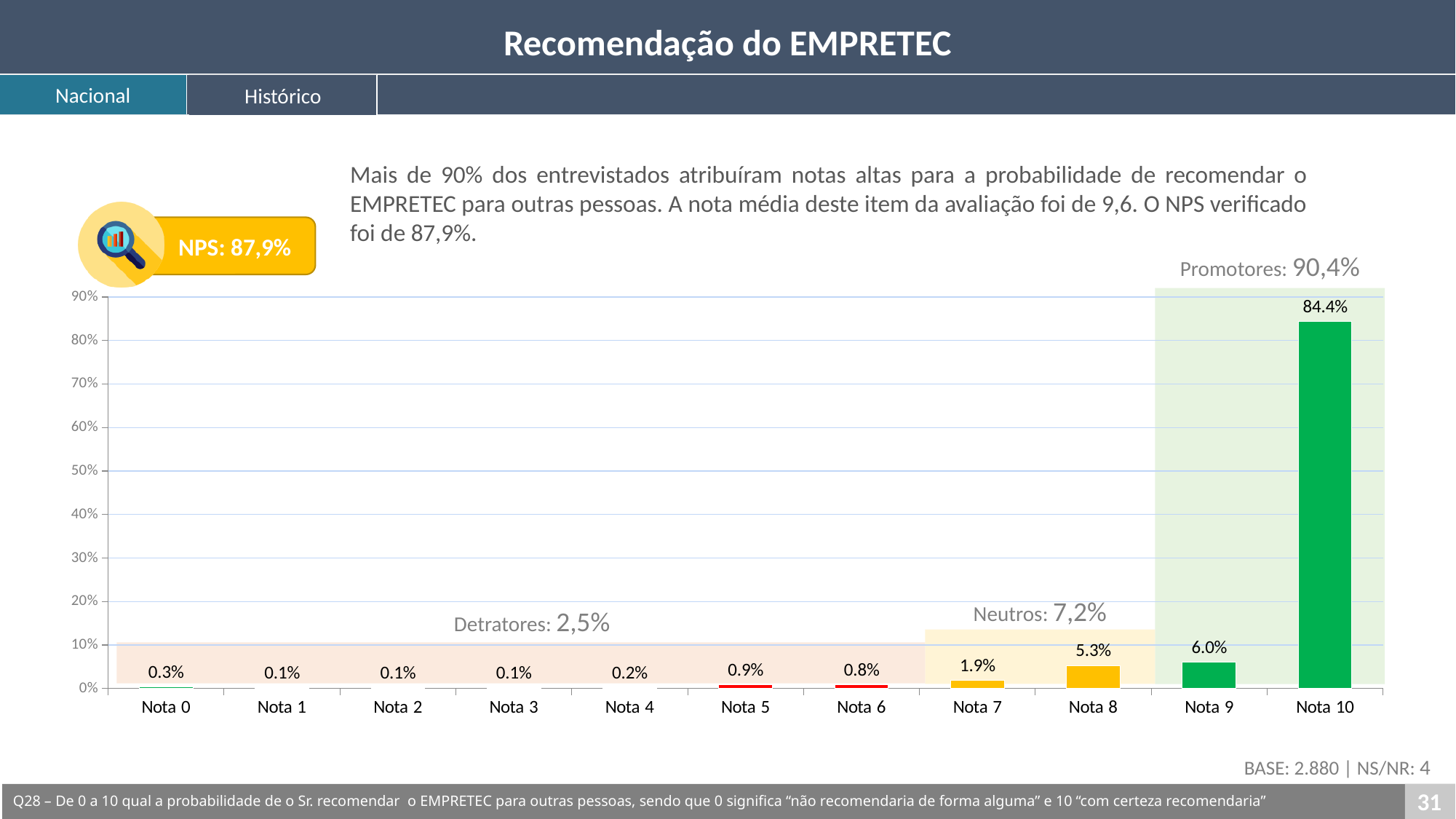
What is the difference between the values for Nota 10 and Nota 9? 78.4% What percentage is shown for Promotores above the chart? 90,4% What is the difference between the values for Nota 8 and Nota 7? 3.4% Which is larger, the value for Nota 9 or the value for Nota 8? Nota 9 Which category has the highest value? Nota 10 What is the NPS value shown in the yellow box on the slide? 87,9% What is the value for Nota 8? 5.3% Is the value for Nota 10 greater or less than 80%? greater What is the value for Nota 5? 0.9% What is the value for Nota 10? 84.4% How many categories are shown on the x axis? 11 What kind of chart is shown on the slide? bar chart